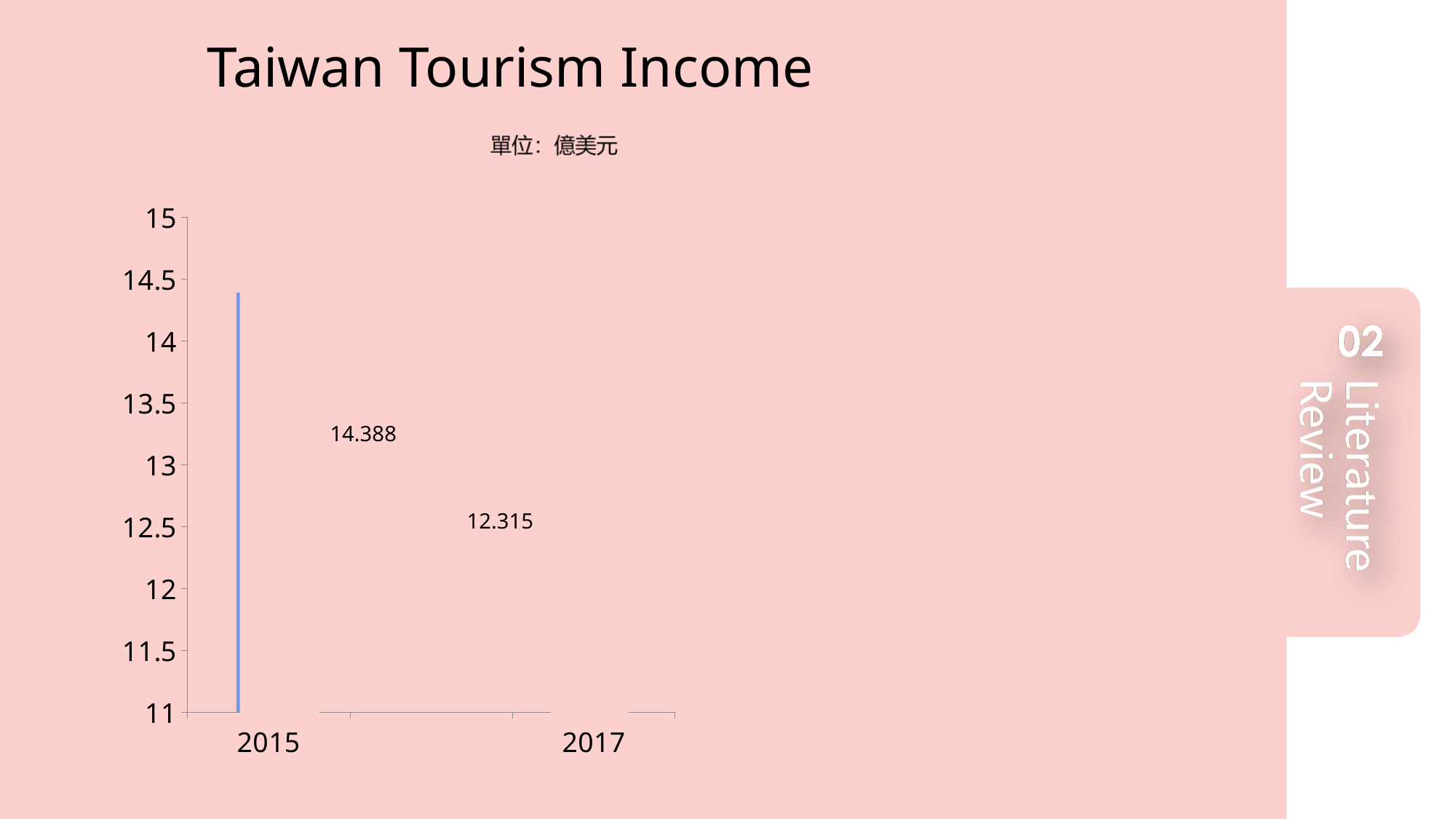
What is the value for 2015? 14.388 What unit is stated below the chart title? 億美元 Is the value for 2015 greater or less than 14? greater What kind of chart is shown on the slide? bar chart Is the value for 2015 greater or less than 14.5? less What is the title of the chart? Taiwan Tourism Income